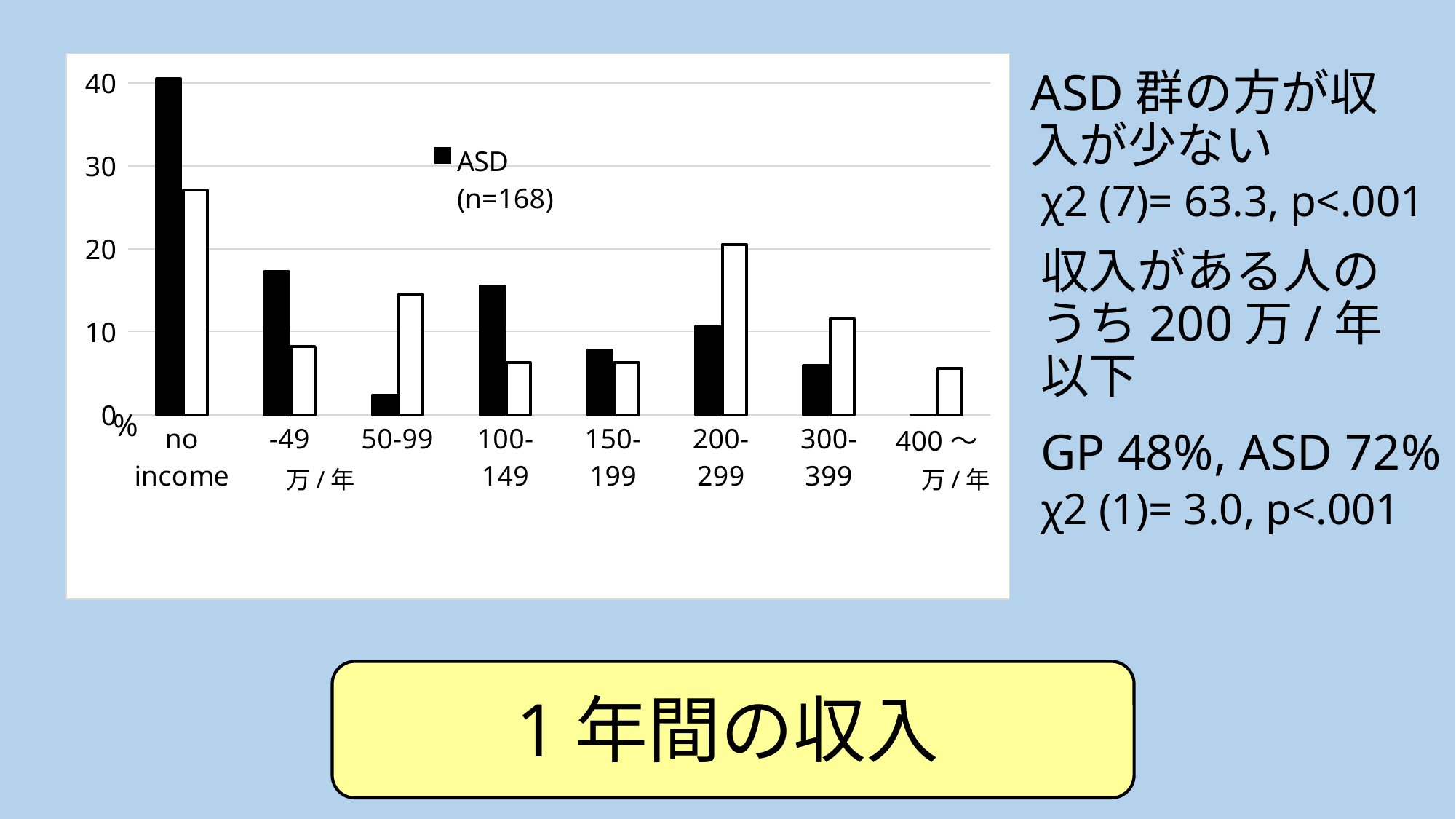
Which income category has the tallest white bar? no income Is the white bar for 'no income' greater or less than 30? less What kind of chart is shown on the slide? bar chart Is the black (ASD) bar for '300-399' greater or less than 10? less How many income categories are shown on the x axis of the chart? 8 Is the black (ASD) bar for '-49' greater or less than 10? greater What colour are the ASD bars in the chart? black For the '200-299' category, which bar is taller, the black (ASD) bar or the white bar? white bar For the 'no income' category, which bar is taller, the black (ASD) bar or the white bar? black (ASD) bar Which income category has the lowest black (ASD) bar? 400～ Which income category has the tallest black (ASD) bar? no income